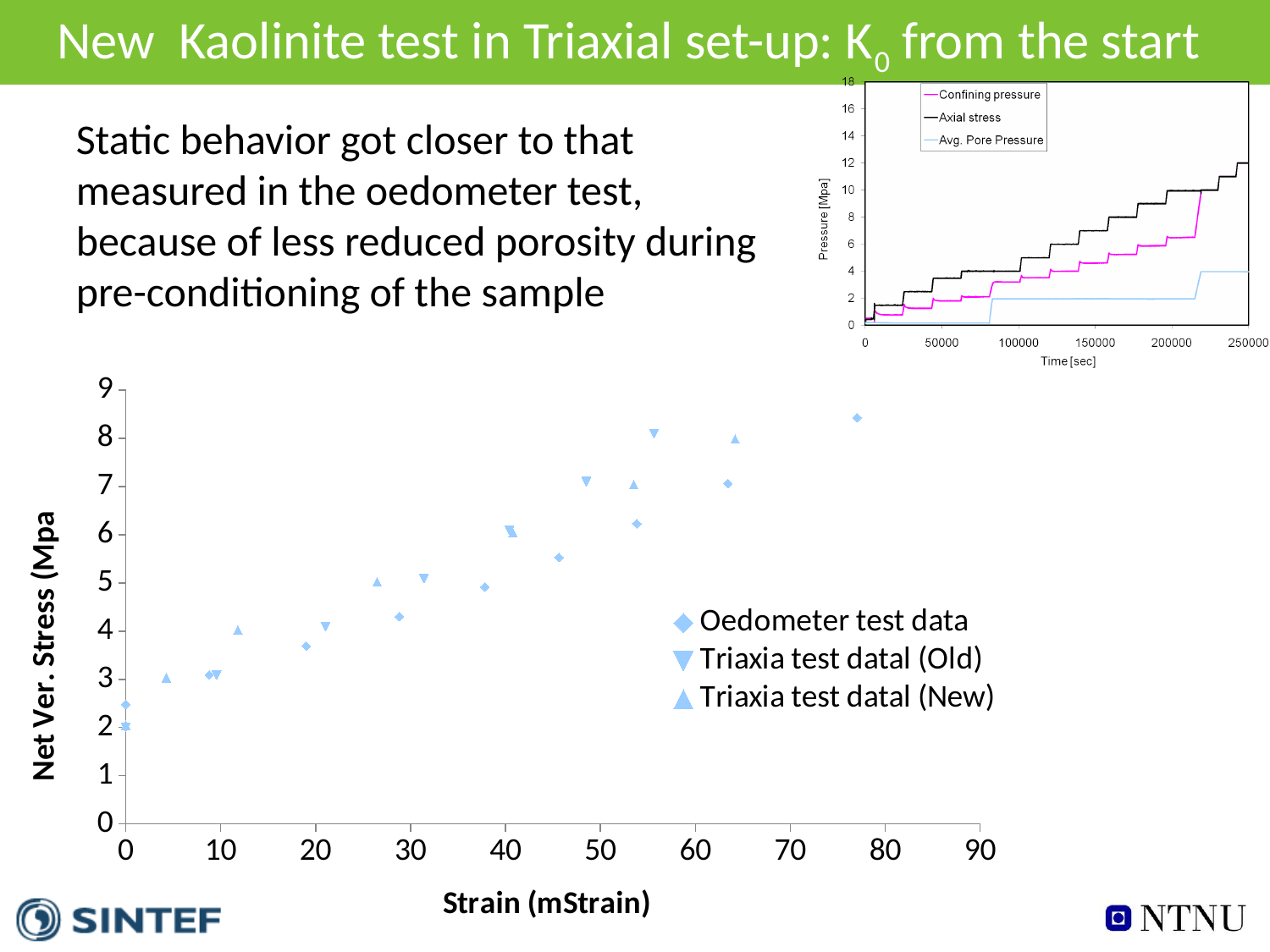
In the bottom chart, do the Oedometer test data values rise or fall as strain increases? Rise In the top-right chart, is the Axial stress value at 250000 sec greater or less than 10? greater In the bottom chart, what is the label of the x axis? Strain (mStrain) In the top-right chart, how many series does the legend list? 3 What kind of chart is the top-right chart with Time [sec] on the x axis? Line chart In the top-right chart, which series stays lowest over the time range? Avg. Pore Pressure What kind of chart is the bottom chart with Strain on the x axis? Scatter chart In the bottom chart, is the Triaxia test datal (New) value at about 12 mStrain greater or less than 5? less In the bottom chart, is the Oedometer test data value at the highest strain (around 77 mStrain) greater or less than 8? greater In the bottom chart, how many series does the legend list? 3 In the bottom chart, what is the label of the y axis? Net Ver. Stress (Mpa) In the top-right chart, which series reaches the highest pressure? Axial stress